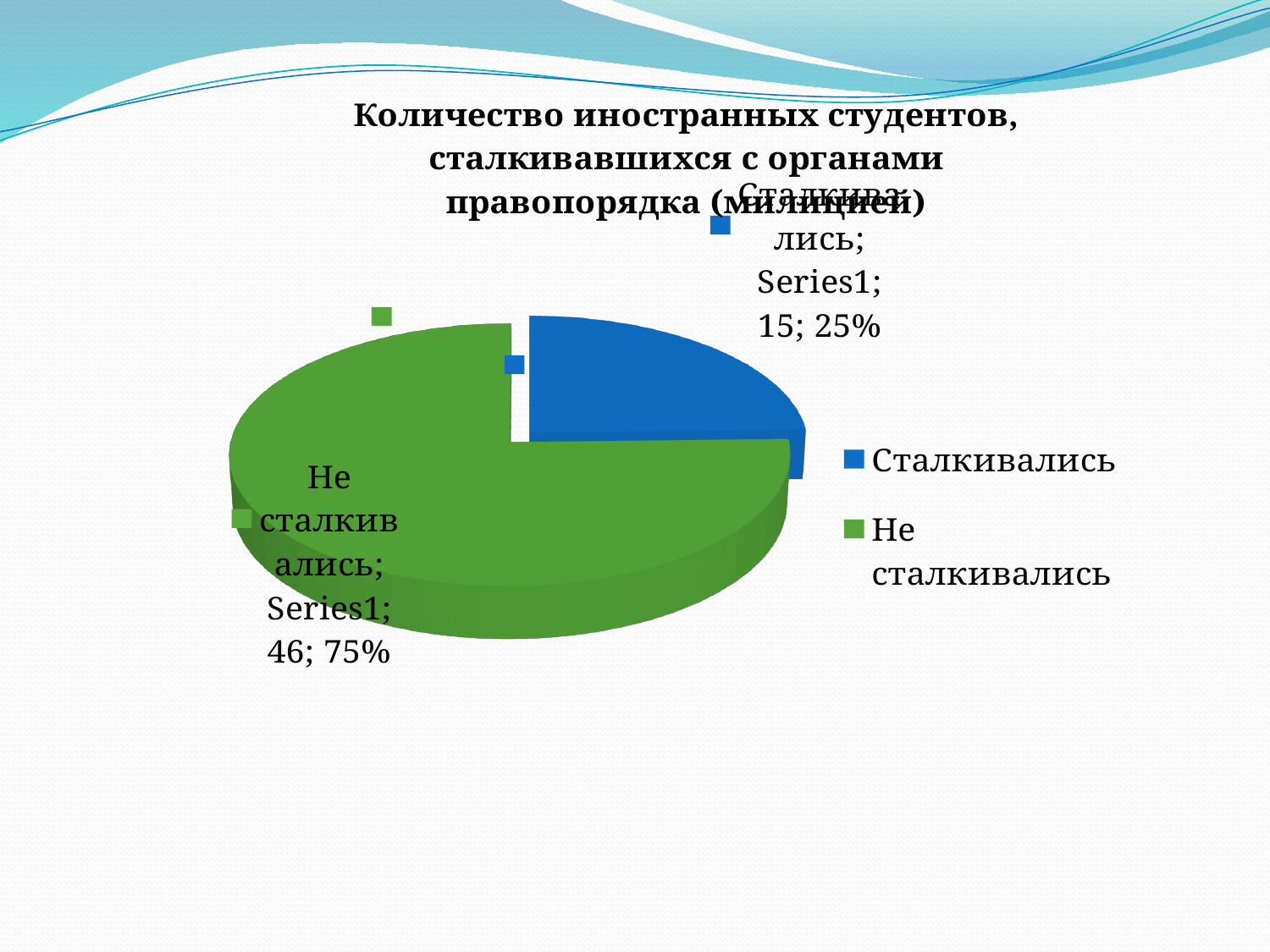
What is the value for "Не сталкивались"? 46 Which category has the largest slice? Не сталкивались What share of the pie does "Не сталкивались" represent? 75% What kind of chart is shown on the slide? pie chart What share of the pie does "Сталкивались" represent? 25% Which is larger, the value for "Сталкивались" or for "Не сталкивались"? Не сталкивались What is the total of the two values shown in the pie chart? 61 What colour is the "Сталкивались" slice? blue Which category has the smallest slice? Сталкивались What is the difference between the values for "Не сталкивались" and "Сталкивались"? 31 How many slices does the pie chart have? 2 What is the value for "Сталкивались"? 15